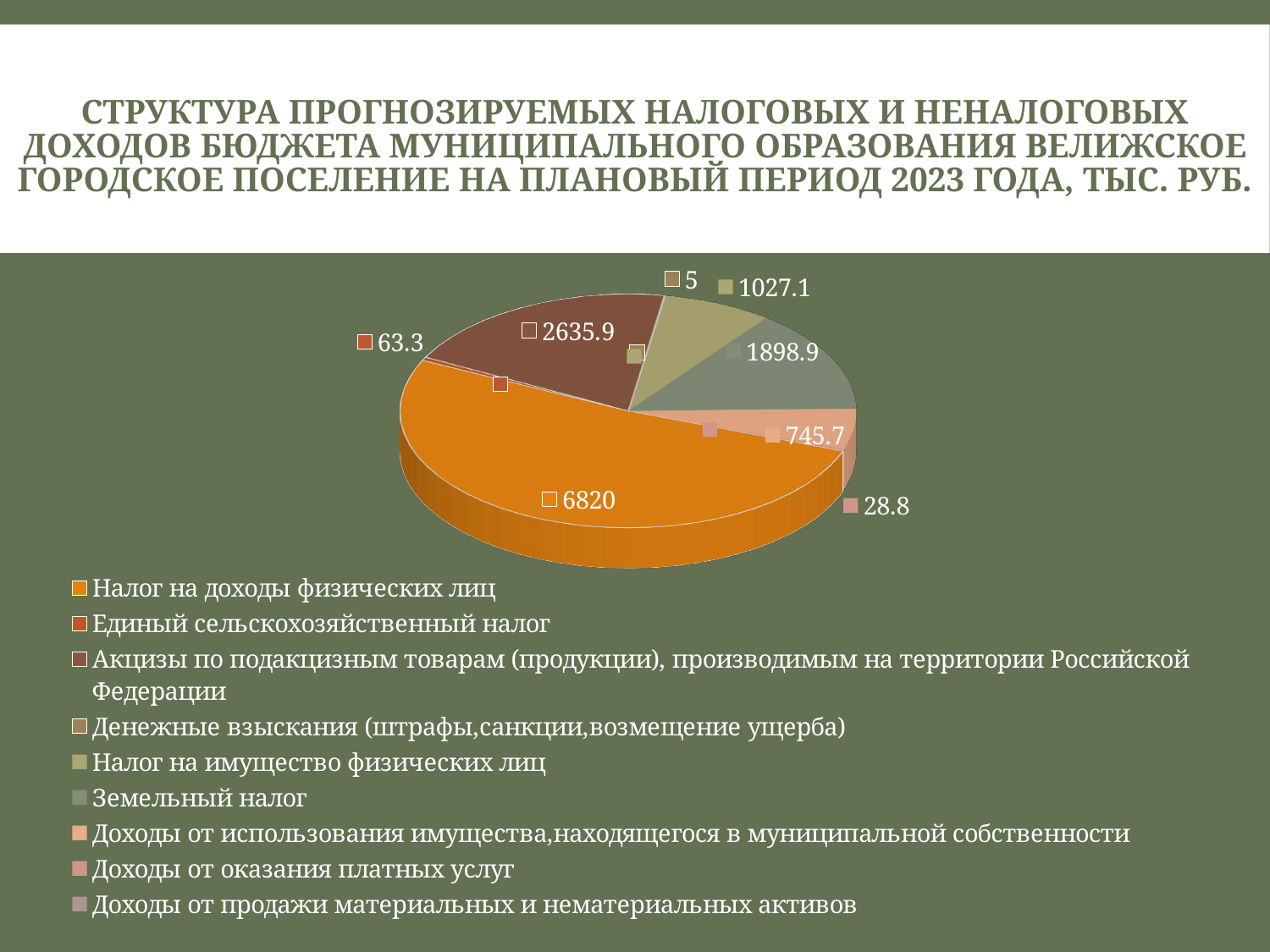
Which category has the largest value? Налог на доходы физических лиц What is the value for Налог на имущество физических лиц? 1027.1 What type of chart is shown on the slide? Pie chart What is the value for Доходы от использования имущества, находящегося в муниципальной собственности? 745.7 What is the difference between the values for Налог на доходы физических лиц and Акцизы по подакцизным товарам? 4184.1 Which is larger: Земельный налог or Налог на имущество физических лиц? Земельный налог How many categories does the legend list? 9 What is the value for Налог на доходы физических лиц? 6820 What is the value for Денежные взыскания (штрафы, санкции, возмещение ущерба)? 5 What is the value for Единый сельскохозяйственный налог? 63.3 What is the value for Земельный налог? 1898.9 What is the value for Акцизы по подакцизным товарам (продукции), производимым на территории Российской Федерации? 2635.9